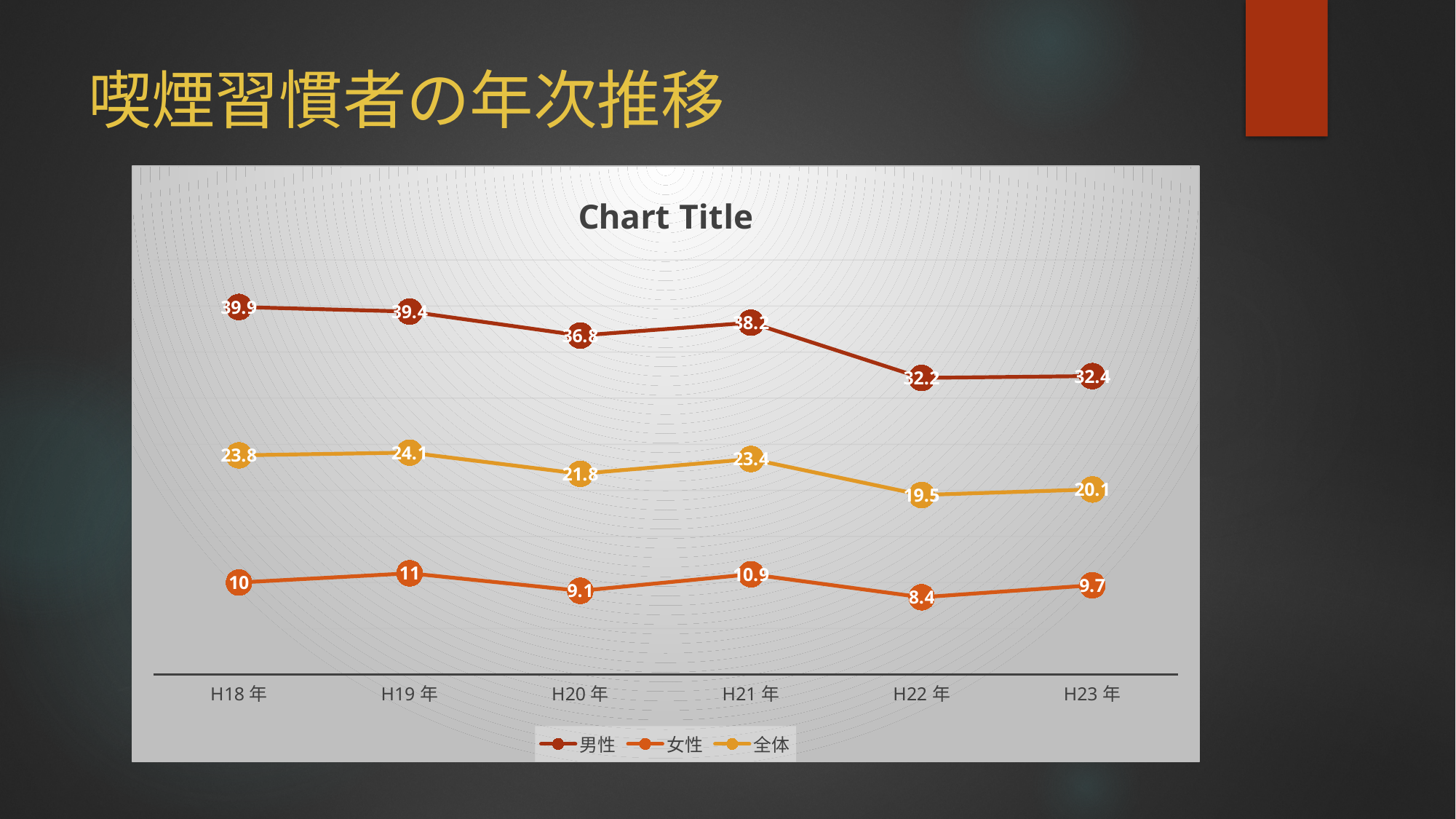
What is the value for 女性 in H22 年? 8.4 In which year is the 全体 series highest? H19 年 What is the difference between the 男性 value in H18 年 and in H23 年? 7.5 How many years are shown on the x axis? 6 What is the title shown inside the chart area? Chart Title In which year is the 男性 series lowest? H22 年 What is the value for 全体 in H20 年? 21.8 Which is larger, the 女性 value in H19 年 or in H21 年? H19 年 How many series does the legend list? 3 Does the 男性 series generally rise or fall from H18 年 to H23 年? fall What kind of chart is this? line chart What is the value for 男性 in H18 年? 39.9